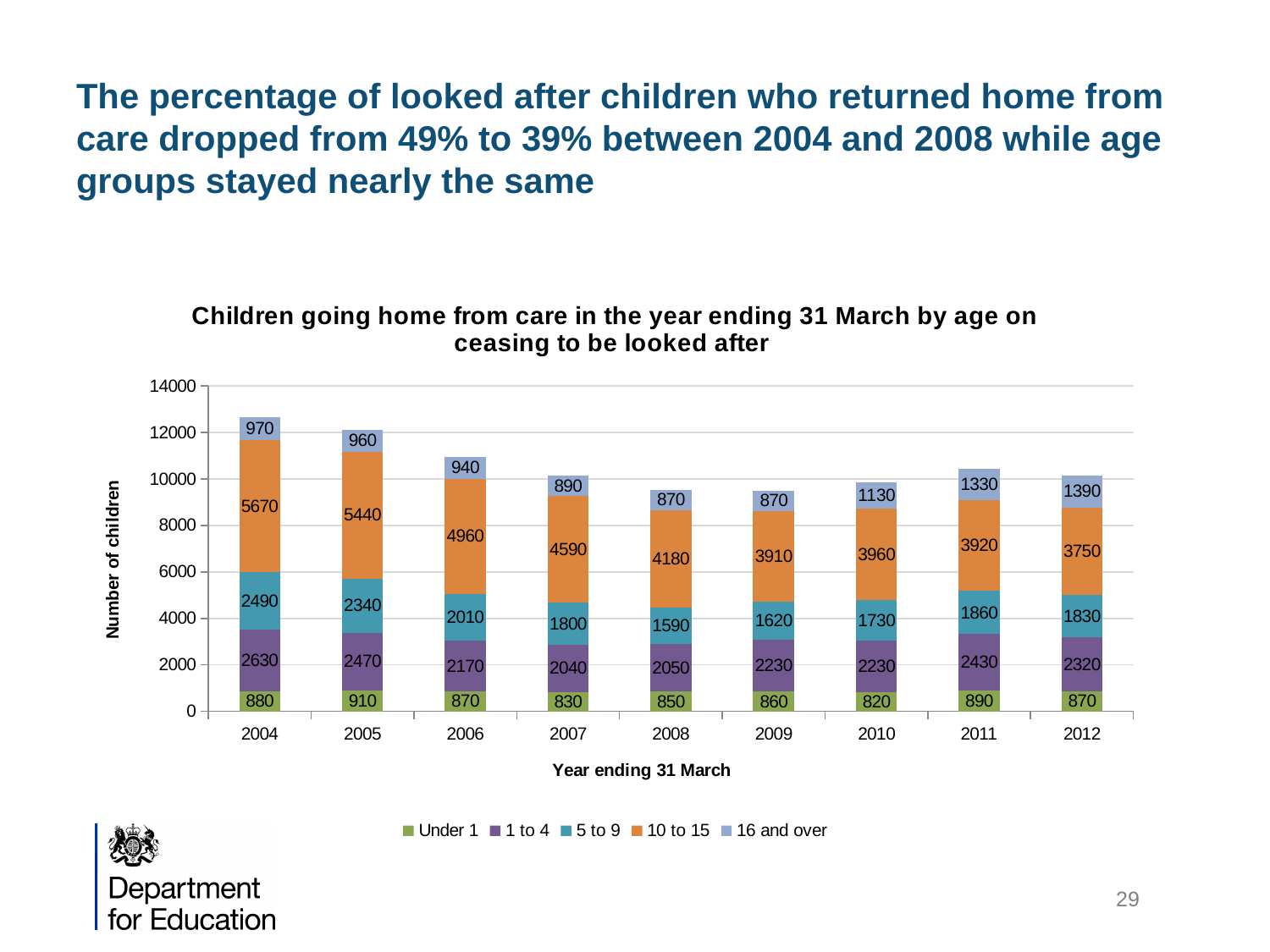
Is the total for the 2004 bar greater or less than 12000? greater What is the total number of children for the 2008 bar? 9540 What is the value for the 5 to 9 age group in 2008? 1590 In which year is the value for the Under 1 age group lowest? 2010 What is the value for the 10 to 15 age group in 2004? 5670 What is the difference between the 10 to 15 values for 2004 and 2012? 1920 In which year is the value for the 10 to 15 age group highest? 2004 What kind of chart is shown on the slide? Stacked bar chart What is the value for the 16 and over age group in 2012? 1390 How many years are shown on the x axis? 9 Which is larger, the 1 to 4 value in 2011 or the 1 to 4 value in 2012? 2011 How many age groups does the legend list? 5